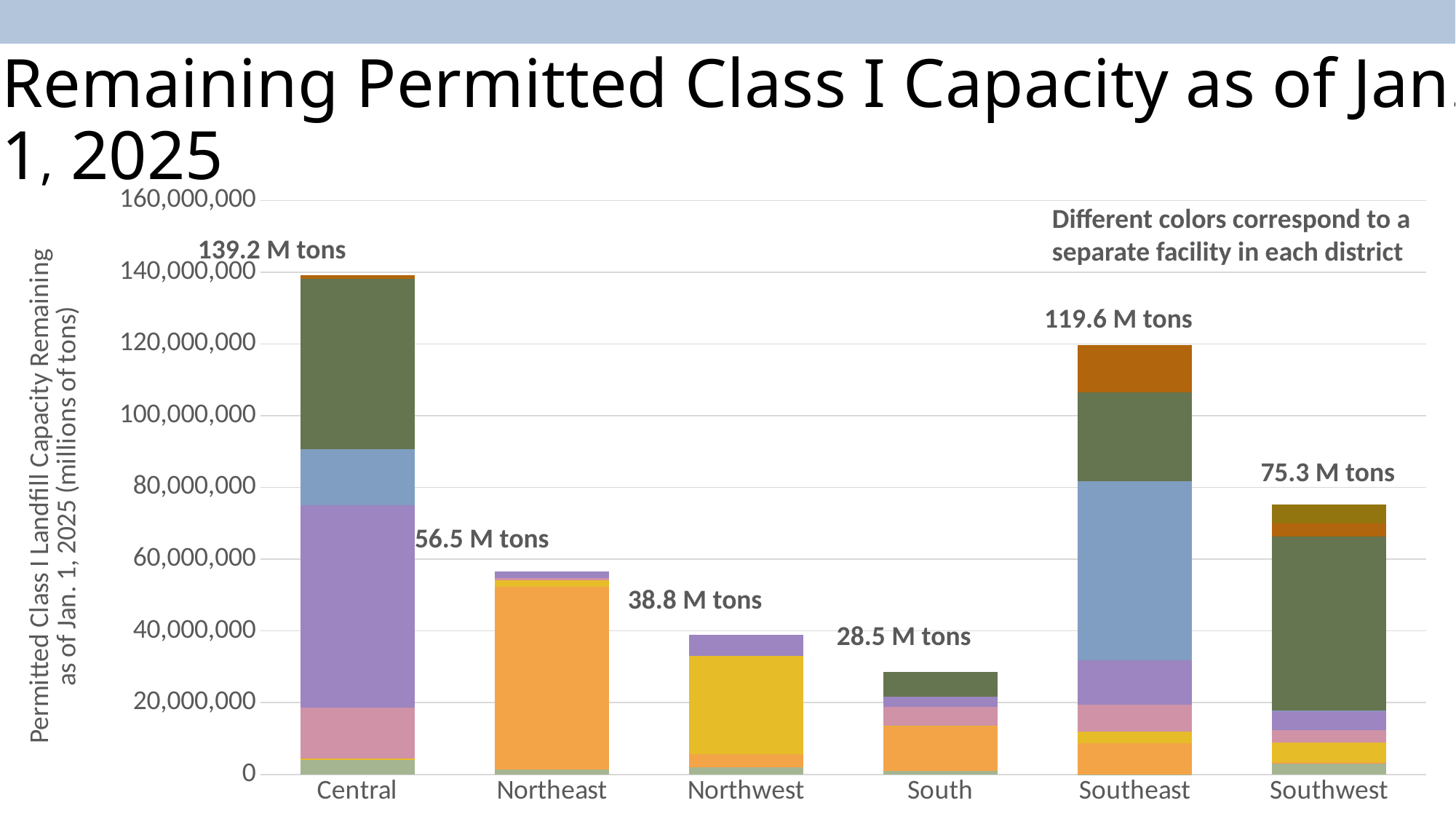
What is the total remaining permitted Class I capacity shown for the Southeast district? 119.6 M tons What is the difference between the total capacity of the Central district and the Southeast district? 19.6 M tons What is the total remaining permitted Class I capacity shown for the Central district? 139.2 M tons According to the note on the chart, what do the different colors in each bar correspond to? A separate facility in each district What kind of chart is shown on the slide? Stacked bar chart What is the total remaining permitted Class I capacity shown for the South district? 28.5 M tons What is the difference between the total capacity of the Northeast district and the Northwest district? 17.7 M tons Is the total value for the Southwest district greater or less than 80,000,000? less Which district has the lowest total remaining permitted Class I capacity? South How many districts are shown on the x axis of the chart? 6 Which district has the highest total remaining permitted Class I capacity? Central Which district has a larger total remaining capacity, Southwest or Northeast? Southwest